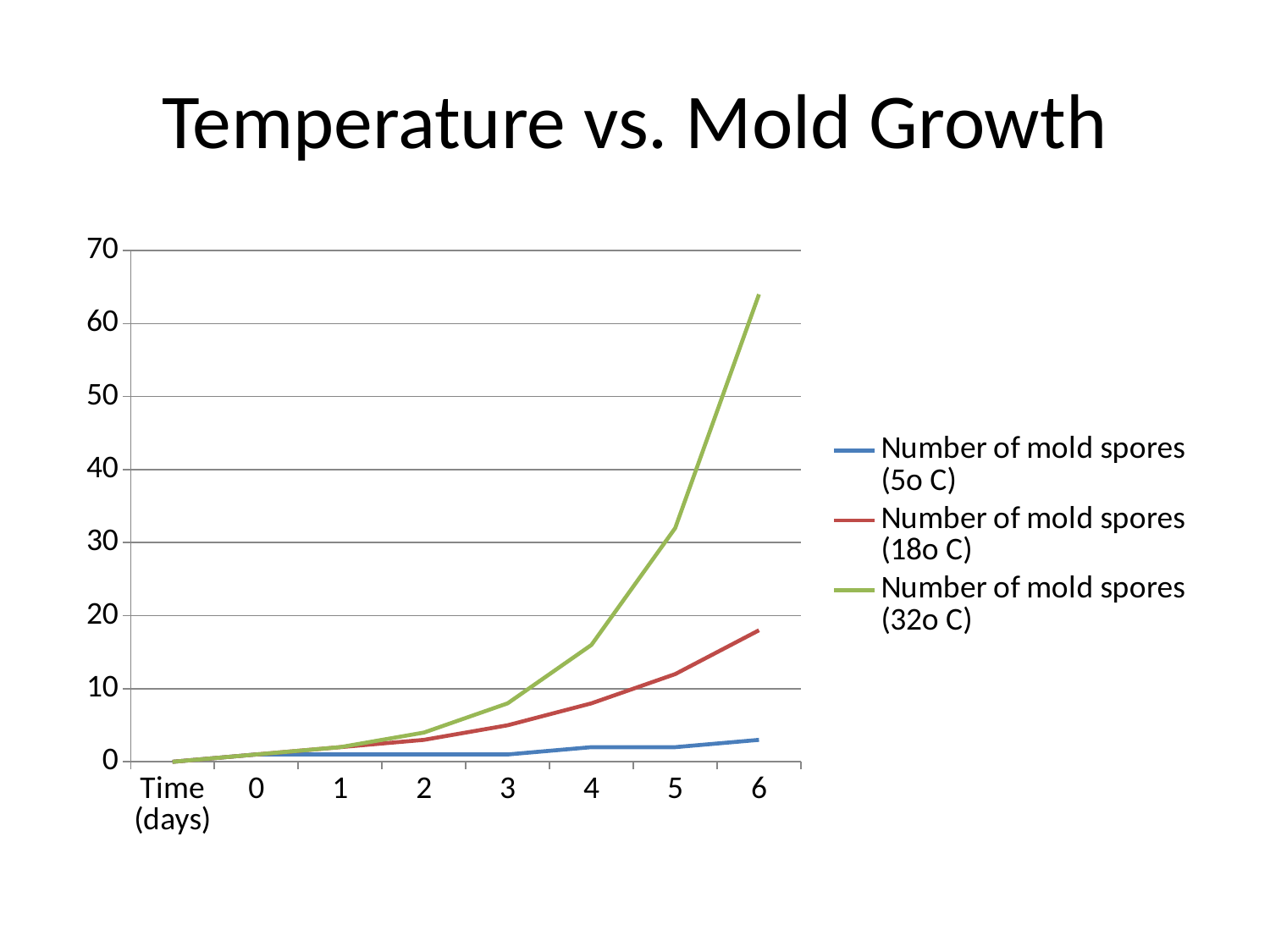
Is the value for Number of mold spores (32o C) at day 6 greater or less than 60? greater Is the value for Number of mold spores (32o C) at day 4 greater or less than 10? greater Which series is lowest at day 6? Number of mold spores (5o C) Is the value for Number of mold spores (18o C) at day 6 greater or less than 20? less Which series is highest at day 6? Number of mold spores (32o C) What kind of chart is shown on the slide? line chart At day 5, which is larger: Number of mold spores (18o C) or Number of mold spores (32o C)? Number of mold spores (32o C) Does the Number of mold spores (32o C) series rise or fall from day 0 to day 6? rise Which colour is used for the Number of mold spores (18o C) series? red How many series does the legend list? 3 What is the title of the chart on the slide? Temperature vs. Mold Growth